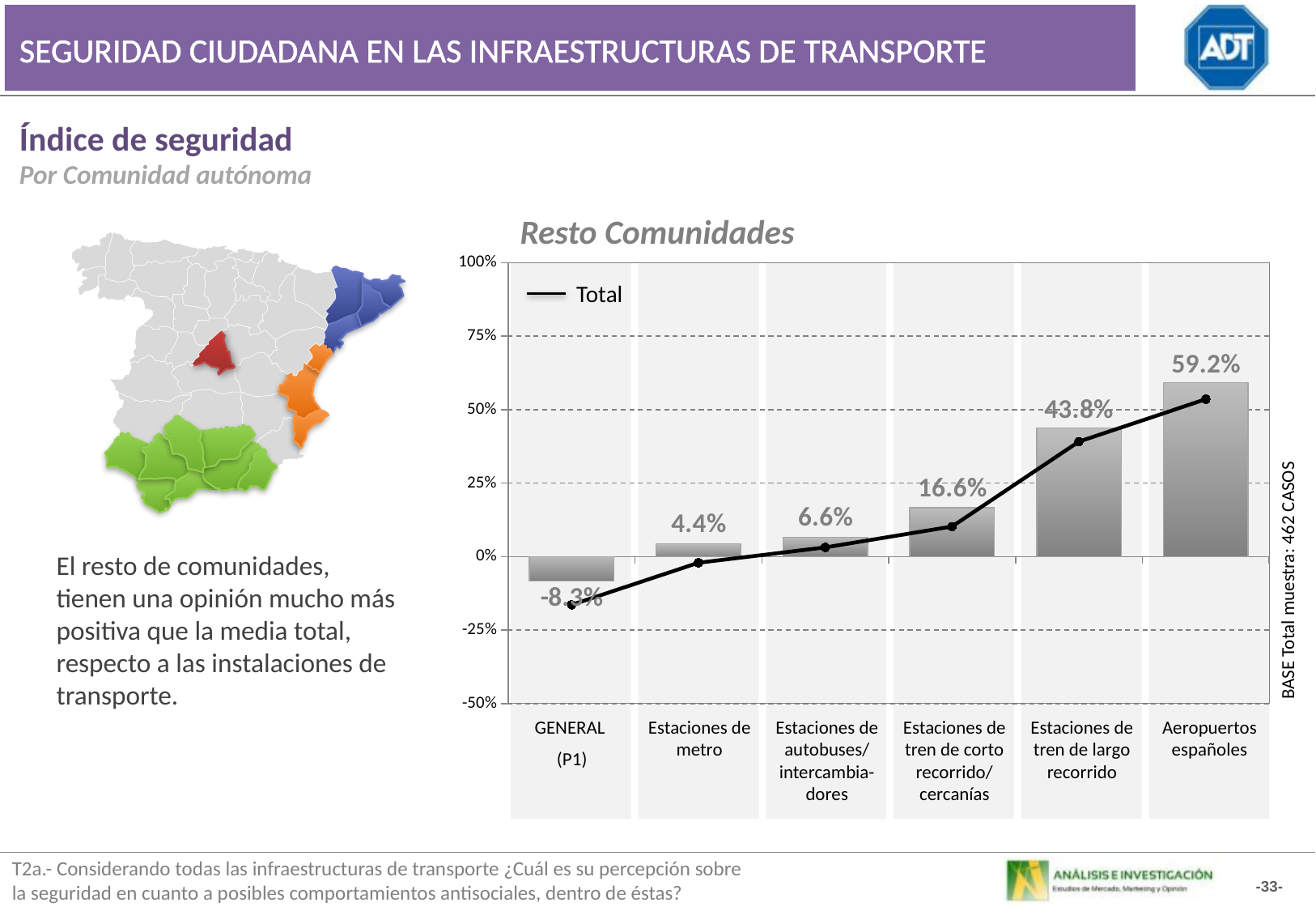
Which has a larger bar value in the Resto Comunidades chart: Estaciones de autobuses/intercambiadores or Estaciones de tren de corto recorrido/cercanías? Estaciones de tren de corto recorrido/cercanías What is the bar value for Estaciones de tren de largo recorrido in the Resto Comunidades chart? 43.8% How many series does the legend of the Resto Comunidades chart list? 1 How many categories are shown on the x axis of the Resto Comunidades chart? 6 Which category has the highest bar value in the Resto Comunidades chart? Aeropuertos españoles Which category has the lowest bar value in the Resto Comunidades chart? GENERAL (P1) Do the bar values in the Resto Comunidades chart rise or fall from left to right along the x axis? rise What is the bar value for Estaciones de metro in the Resto Comunidades chart? 4.4% What is the bar value for GENERAL (P1) in the Resto Comunidades chart? -8.3% Is the Total line value for Aeropuertos españoles greater or less than 50% in the Resto Comunidades chart? greater What is the difference between the bar values for Aeropuertos españoles and Estaciones de tren de largo recorrido in the Resto Comunidades chart? 15.4% What is the bar value for Aeropuertos españoles in the Resto Comunidades chart? 59.2%